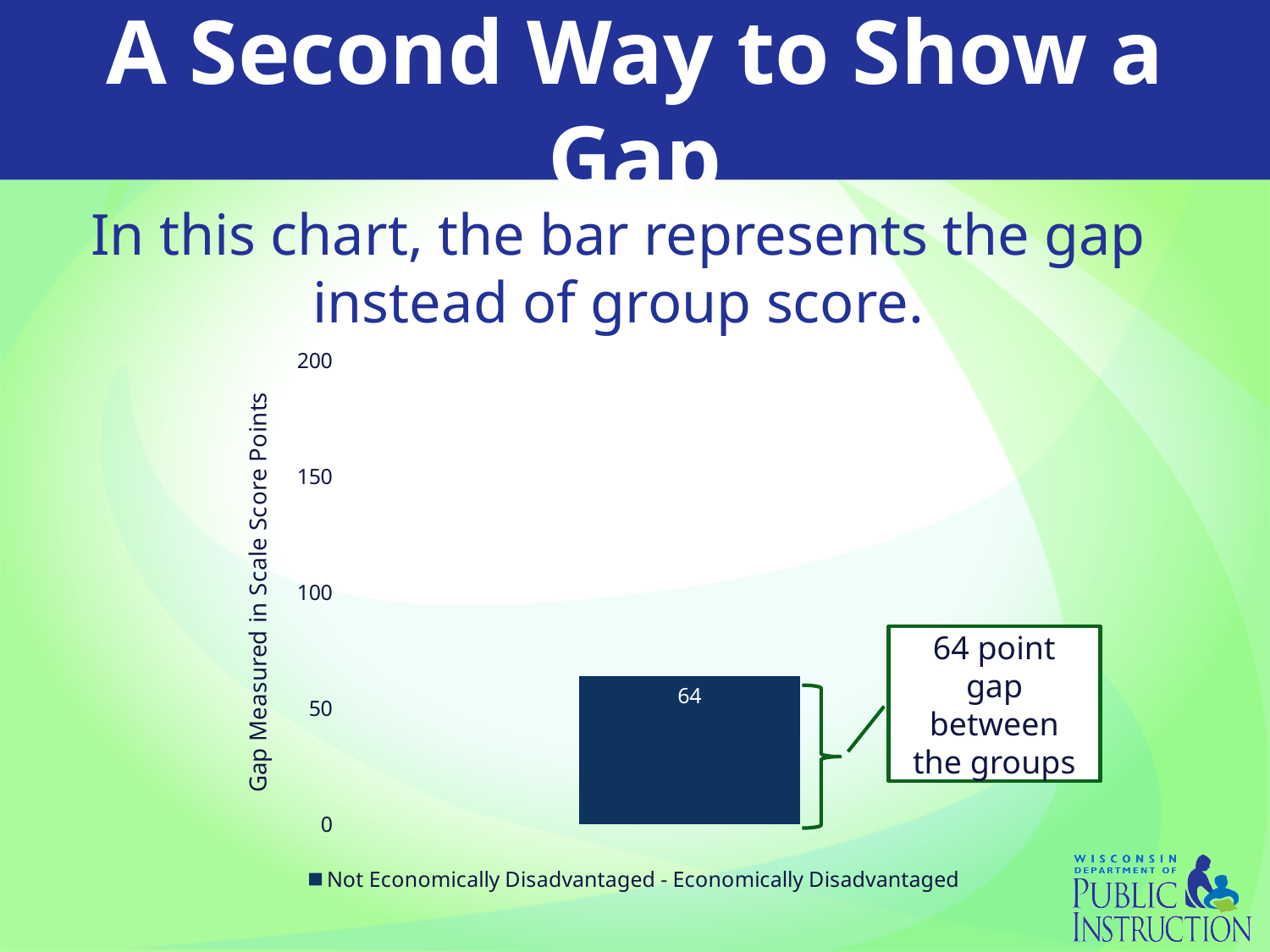
According to the callout box, how many points is the gap between the groups? 64 What is the legend entry for the series in the chart? Not Economically Disadvantaged - Economically Disadvantaged Is the value of the bar greater or less than 50? greater What kind of chart is shown on the slide? bar chart What is the value shown on the bar in the chart? 64 How many series does the chart legend list? 1 How many bars are plotted in the chart? 1 What is the highest tick value shown on the vertical axis? 200 Is the value of the bar greater or less than 100? less What is the label of the vertical axis in the chart? Gap Measured in Scale Score Points What is the value for the series 'Not Economically Disadvantaged - Economically Disadvantaged'? 64